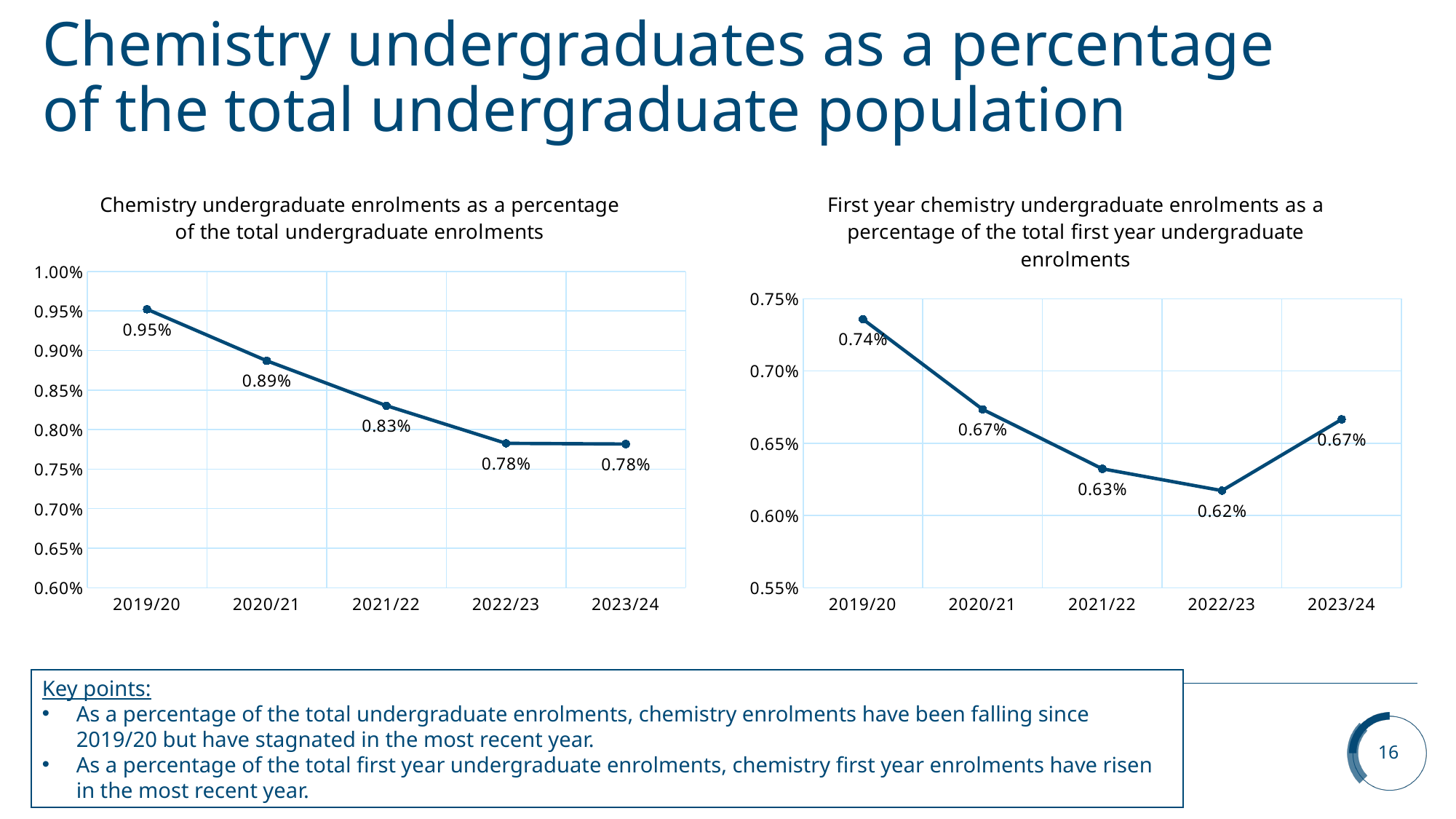
What type of chart is the left chart (Chemistry undergraduate enrolments as a percentage of the total undergraduate enrolments)? line chart In the left chart (Chemistry undergraduate enrolments as a percentage of the total undergraduate enrolments), how many years are plotted? 5 In the right chart (First year chemistry undergraduate enrolments as a percentage of the total first year undergraduate enrolments), what is the difference between the 2019/20 and 2022/23 values? 0.12% In the right chart (First year chemistry undergraduate enrolments as a percentage of the total first year undergraduate enrolments), which year has the lowest value? 2022/23 In the left chart (Chemistry undergraduate enrolments as a percentage of the total undergraduate enrolments), what is the value for 2019/20? 0.95% In the left chart (Chemistry undergraduate enrolments as a percentage of the total undergraduate enrolments), what is the difference between the 2019/20 and 2023/24 values? 0.17% In the left chart (Chemistry undergraduate enrolments as a percentage of the total undergraduate enrolments), which year has the highest value? 2019/20 In the right chart (First year chemistry undergraduate enrolments as a percentage of the total first year undergraduate enrolments), which is larger, the value for 2019/20 or the value for 2021/22? 2019/20 In the right chart (First year chemistry undergraduate enrolments as a percentage of the total first year undergraduate enrolments), what is the value for 2023/24? 0.67% In the left chart (Chemistry undergraduate enrolments as a percentage of the total undergraduate enrolments), do the values generally rise or fall from 2019/20 to 2023/24? fall In the left chart (Chemistry undergraduate enrolments as a percentage of the total undergraduate enrolments), what is the value for 2021/22? 0.83% In the right chart (First year chemistry undergraduate enrolments as a percentage of the total first year undergraduate enrolments), what is the value for 2022/23? 0.62%